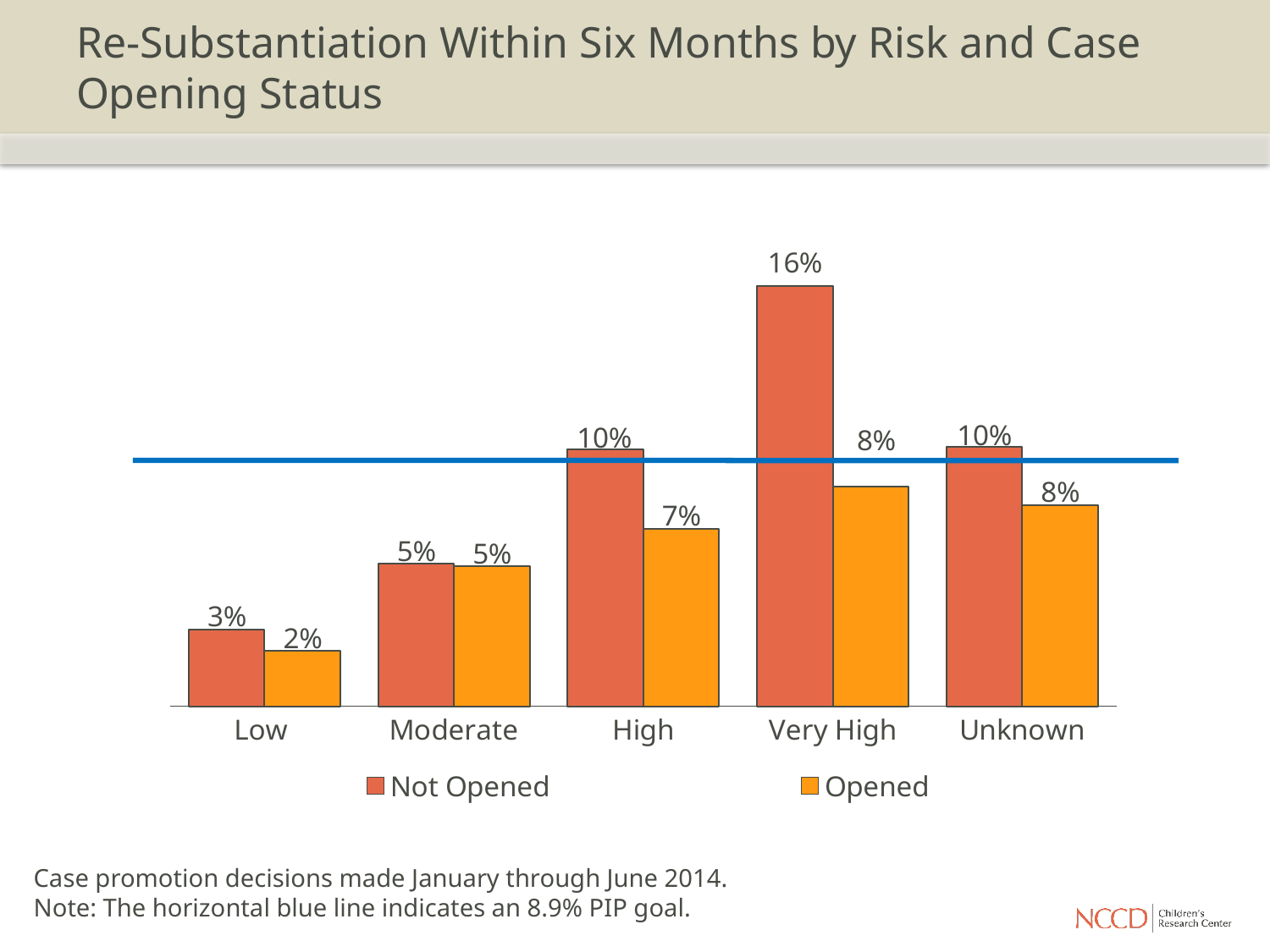
What does the horizontal blue line on the chart indicate? An 8.9% PIP goal What colour are the Opened bars? Orange What is the difference between the Not Opened and Opened values for the Very High category? 8% Which is larger for the Unknown category, the Not Opened value or the Opened value? Not Opened How many risk categories are shown on the x axis? 5 Which risk category has the lowest Opened value? Low What is the Opened value for the Low risk category? 2% How many series does the legend list? 2 What is the Not Opened value for the Very High risk category? 16% What kind of chart is shown on the slide? Bar chart What is the Opened value for the High risk category? 7% Which risk category has the highest Not Opened value? Very High